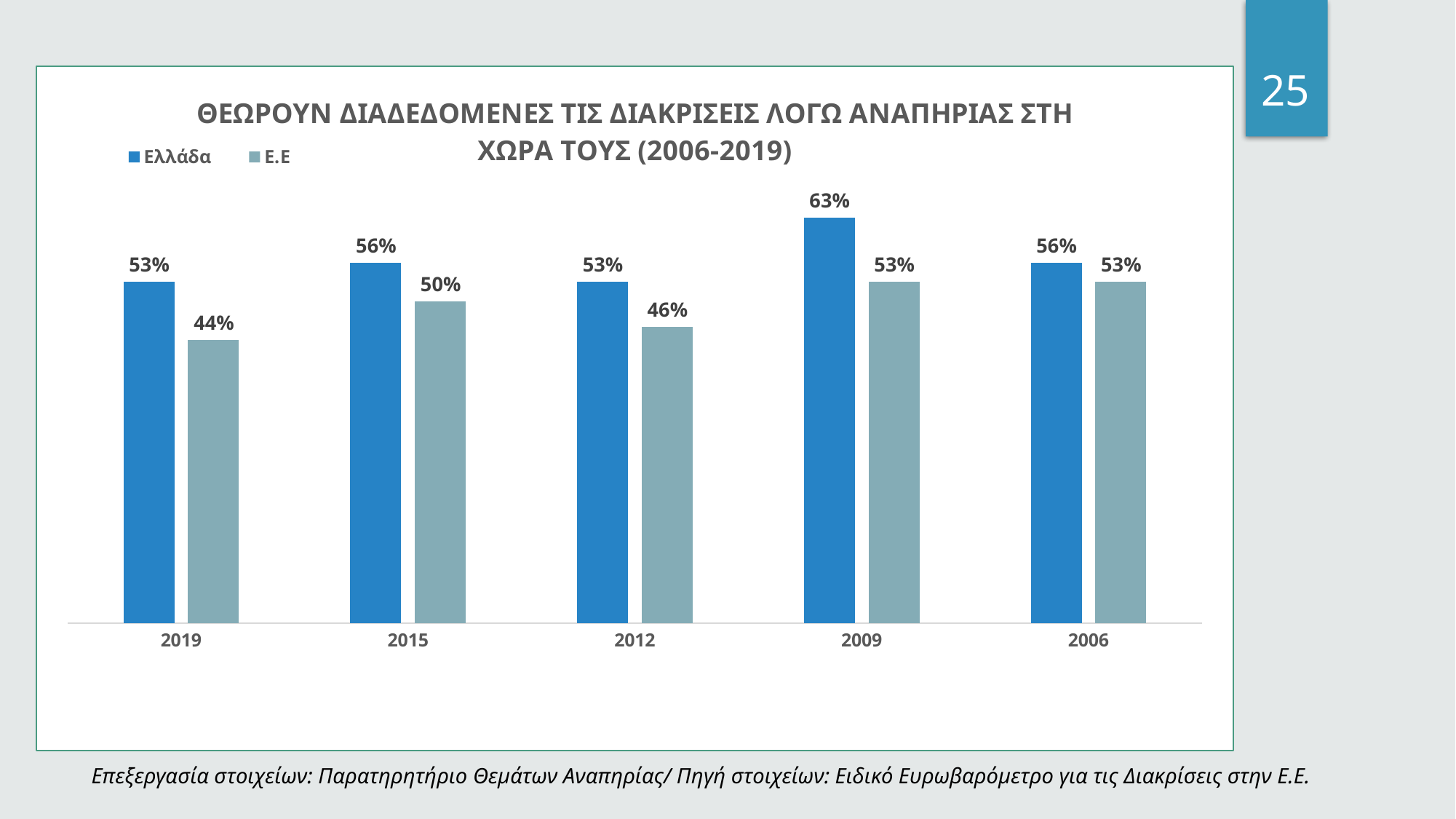
In which year is the value for Ελλάδα highest? 2009 How many series does the legend list? 2 What is the value for Ε.Ε in 2019? 44% What kind of chart is shown on the slide? Bar chart What is the value for Ε.Ε in 2012? 46% What is the difference between the Ελλάδα and Ε.Ε values in 2009? 10% How many years are shown on the x axis? 5 What is the value for Ελλάδα in 2015? 56% What is the difference between the Ελλάδα and Ε.Ε values in 2019? 9% Which is larger in 2012, the value for Ελλάδα or for Ε.Ε? Ελλάδα In which year is the value for Ε.Ε lowest? 2019 What is the value for Ελλάδα in 2009? 63%